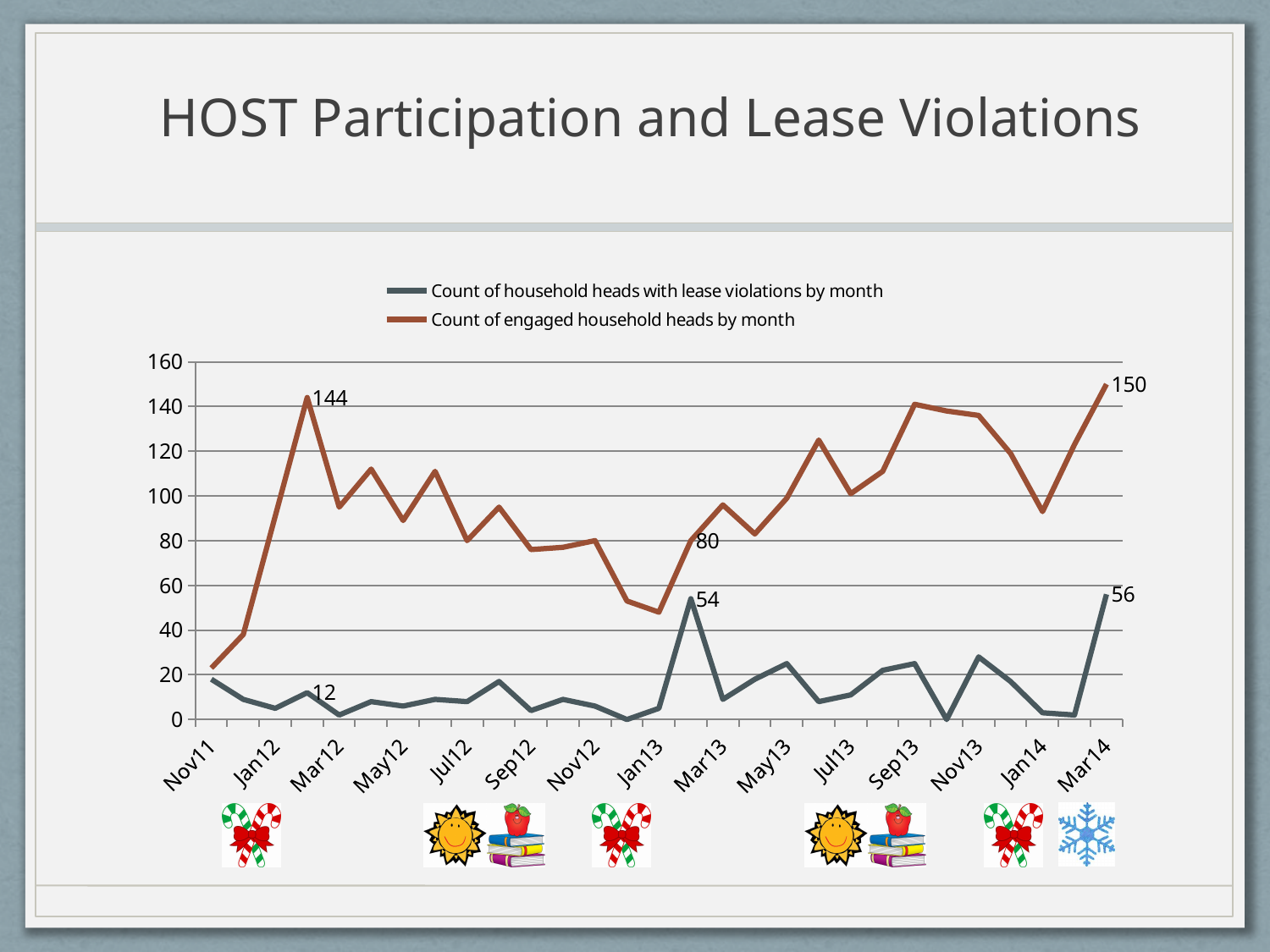
How many series does the legend list? 2 Does the count of engaged household heads rise or fall from Jan14 to Mar14? rise Which is larger, the count of engaged household heads in Mar12 or in Mar14? Mar14 Is the count of engaged household heads in Nov11 greater or less than 40? less What is the difference between the engaged household heads count and the lease violations count in Mar14? 94 What kind of chart is shown on the slide? line chart What is the count of household heads with lease violations in Mar14? 56 Which month has the highest count of engaged household heads? Mar14 What is the count of engaged household heads in Mar14? 150 Is the count of engaged household heads in Sep13 greater or less than 120? greater